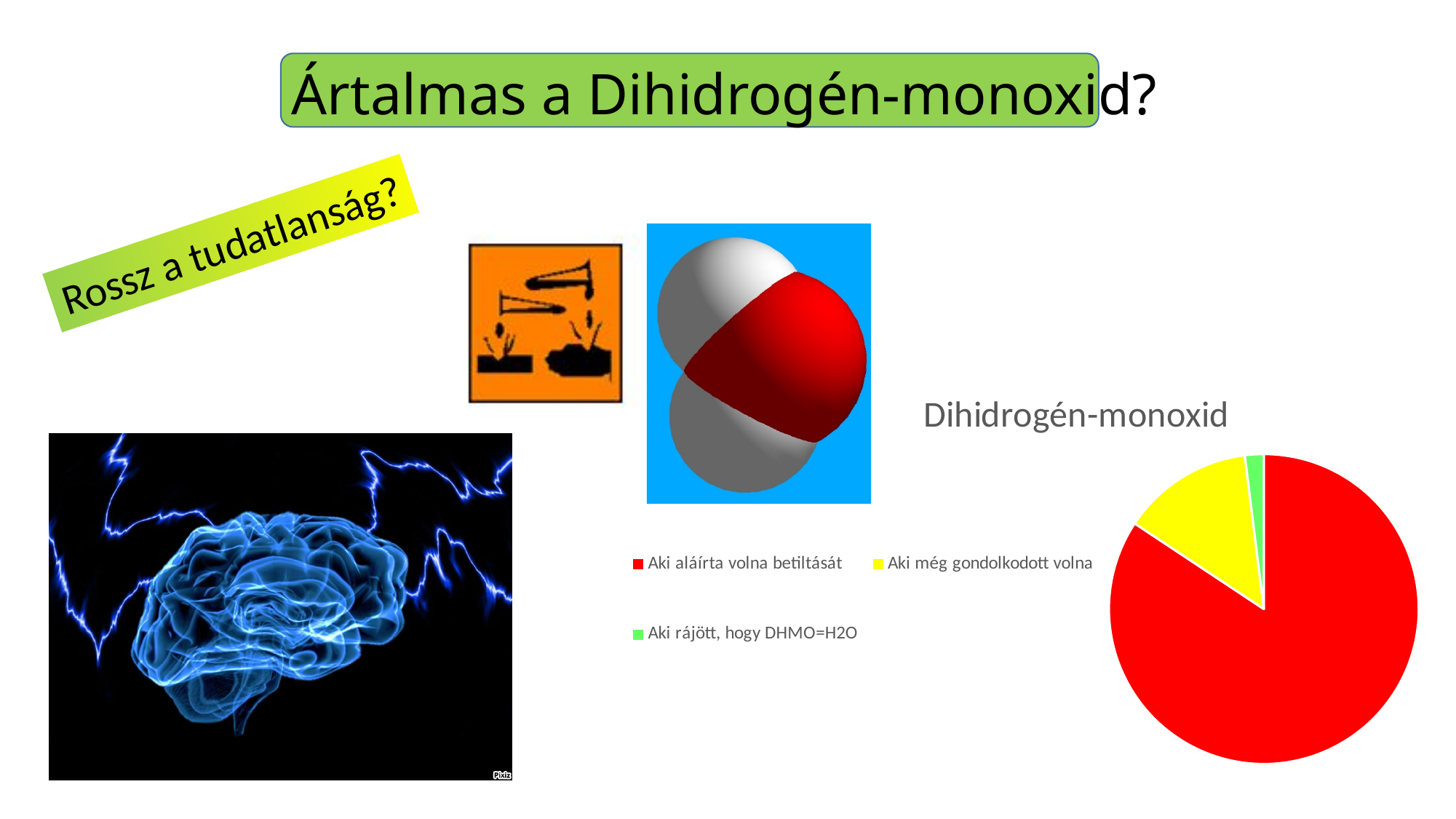
How many entries does the legend of the pie chart list? 3 What colour is the slice for 'Aki még gondolkodott volna' in the pie chart? yellow Which category has the smallest slice in the pie chart? Aki rájött, hogy DHMO=H2O Which category has the largest slice in the pie chart? Aki aláírta volna betiltását What kind of chart is shown on the slide? pie chart What is the title of the pie chart? Dihidrogén-monoxid Which slice is larger: 'Aki még gondolkodott volna' or 'Aki rájött, hogy DHMO=H2O'? Aki még gondolkodott volna Which slice is larger: 'Aki aláírta volna betiltását' or 'Aki még gondolkodott volna'? Aki aláírta volna betiltását How many slices does the pie chart have? 3